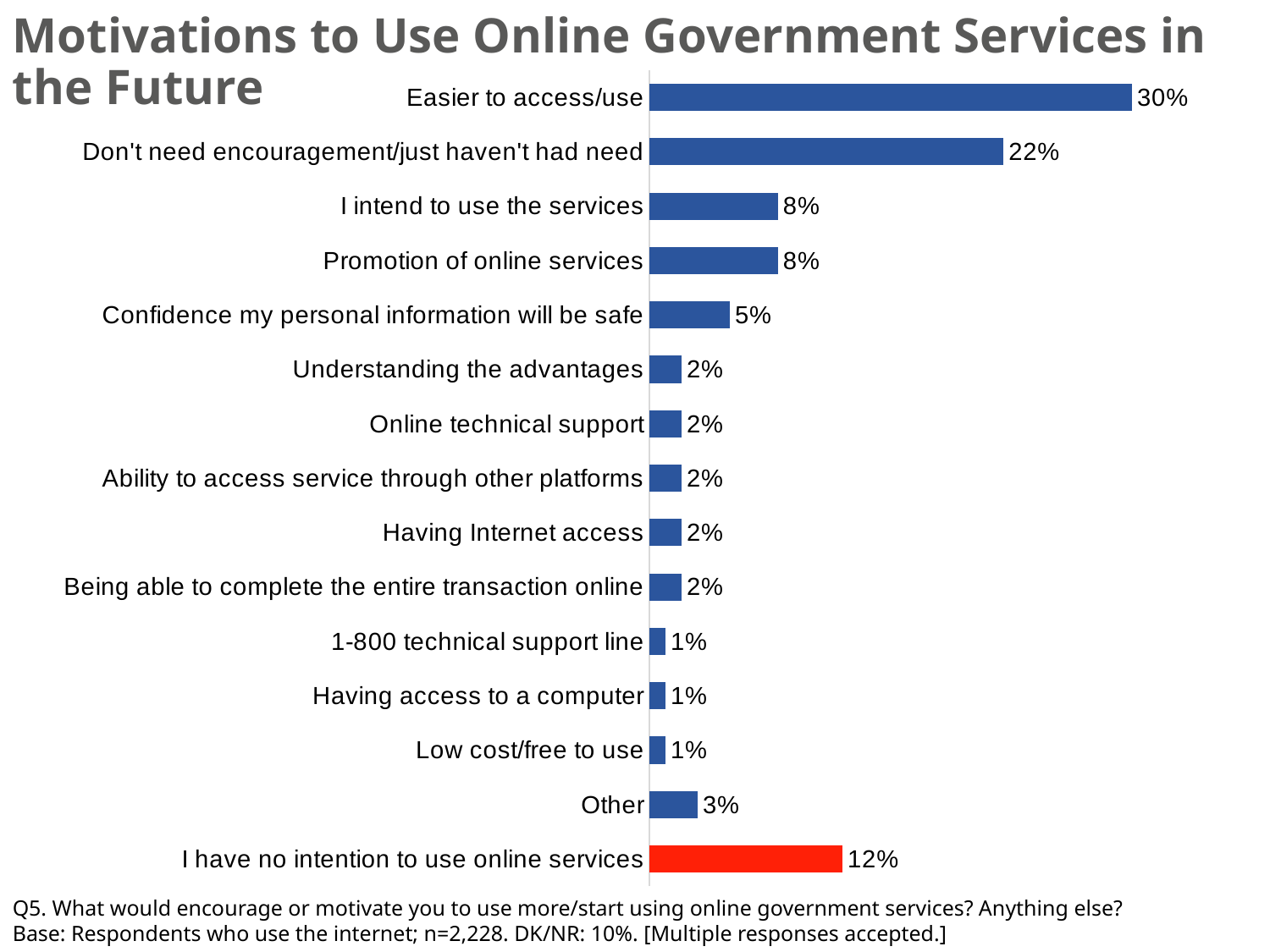
What is the value for "Easier to access/use"? 30% What is the value for "Confidence my personal information will be safe"? 5% What is the value for "I have no intention to use online services"? 12% Which category has the highest value? Easier to access/use Which is larger, "Promotion of online services" or "Confidence my personal information will be safe"? Promotion of online services What kind of chart is this? Bar chart What is the value for "Other"? 3% What is the difference between "I have no intention to use online services" and "I intend to use the services"? 4% Which is larger, "Other" or "Low cost/free to use"? Other Which bar is shown in red rather than blue? I have no intention to use online services What is the difference between "Easier to access/use" and "Don't need encouragement/just haven't had need"? 8% How many categories are shown in the chart? 15